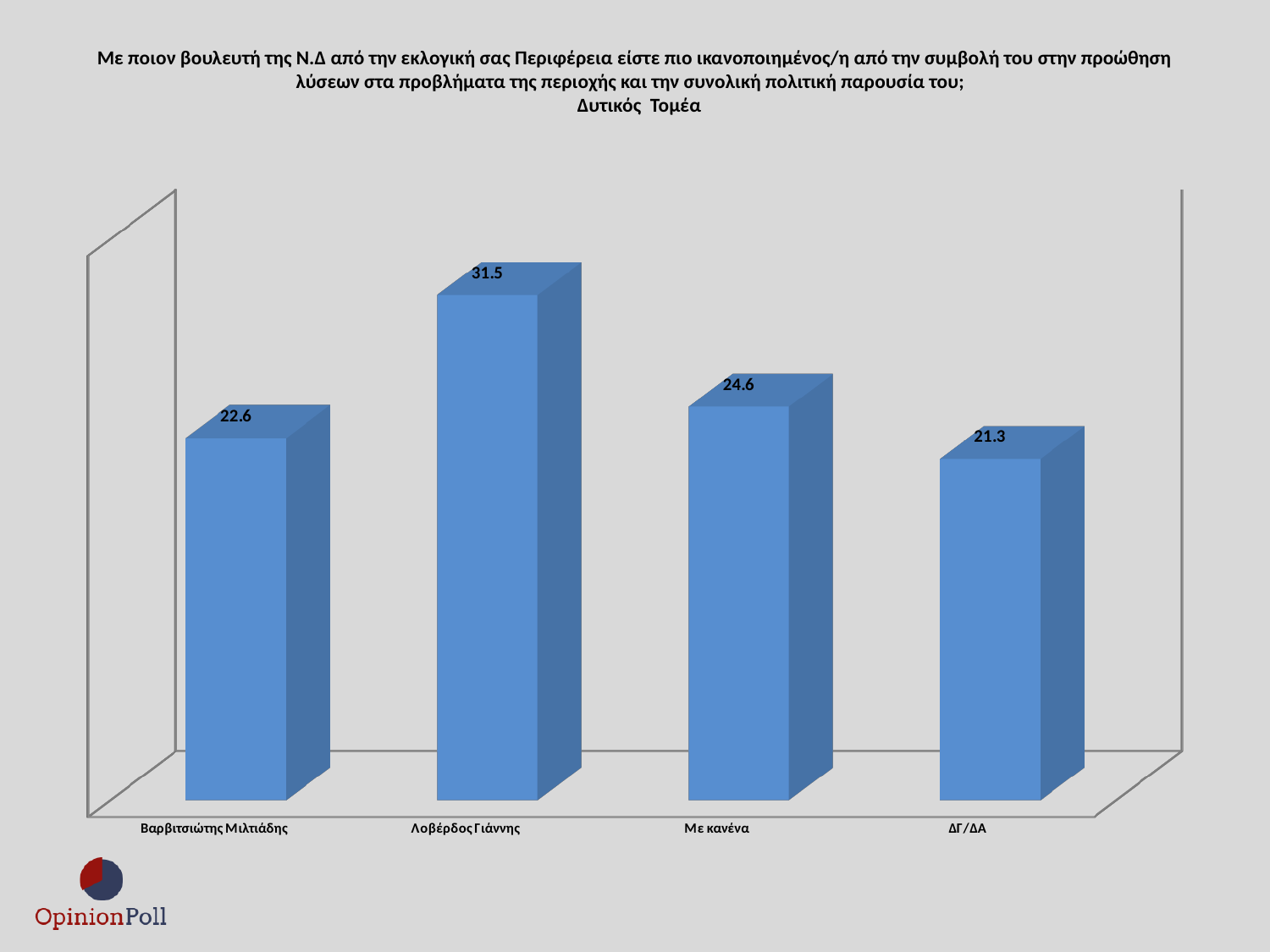
What is the difference between the values for Με κανένα and ΔΓ/ΔΑ? 3.3 Which category has the lowest value? ΔΓ/ΔΑ Which category has the highest value? Λοβέρδος Γιάννης What is the value for Λοβέρδος Γιάννης? 31.5 What is the value for Βαρβιτσιώτης Μιλτιάδης? 22.6 What is the value for ΔΓ/ΔΑ? 21.3 Which is larger, the value for Βαρβιτσιώτης Μιλτιάδης or the value for Με κανένα? Με κανένα What is the value for Με κανένα? 24.6 What kind of chart is shown on the slide? Bar chart How many categories are shown on the chart? 4 What is the difference between the values for Λοβέρδος Γιάννης and Βαρβιτσιώτης Μιλτιάδης? 8.9 Which region (Τομέας) does the chart title refer to? Δυτικός Τομέα